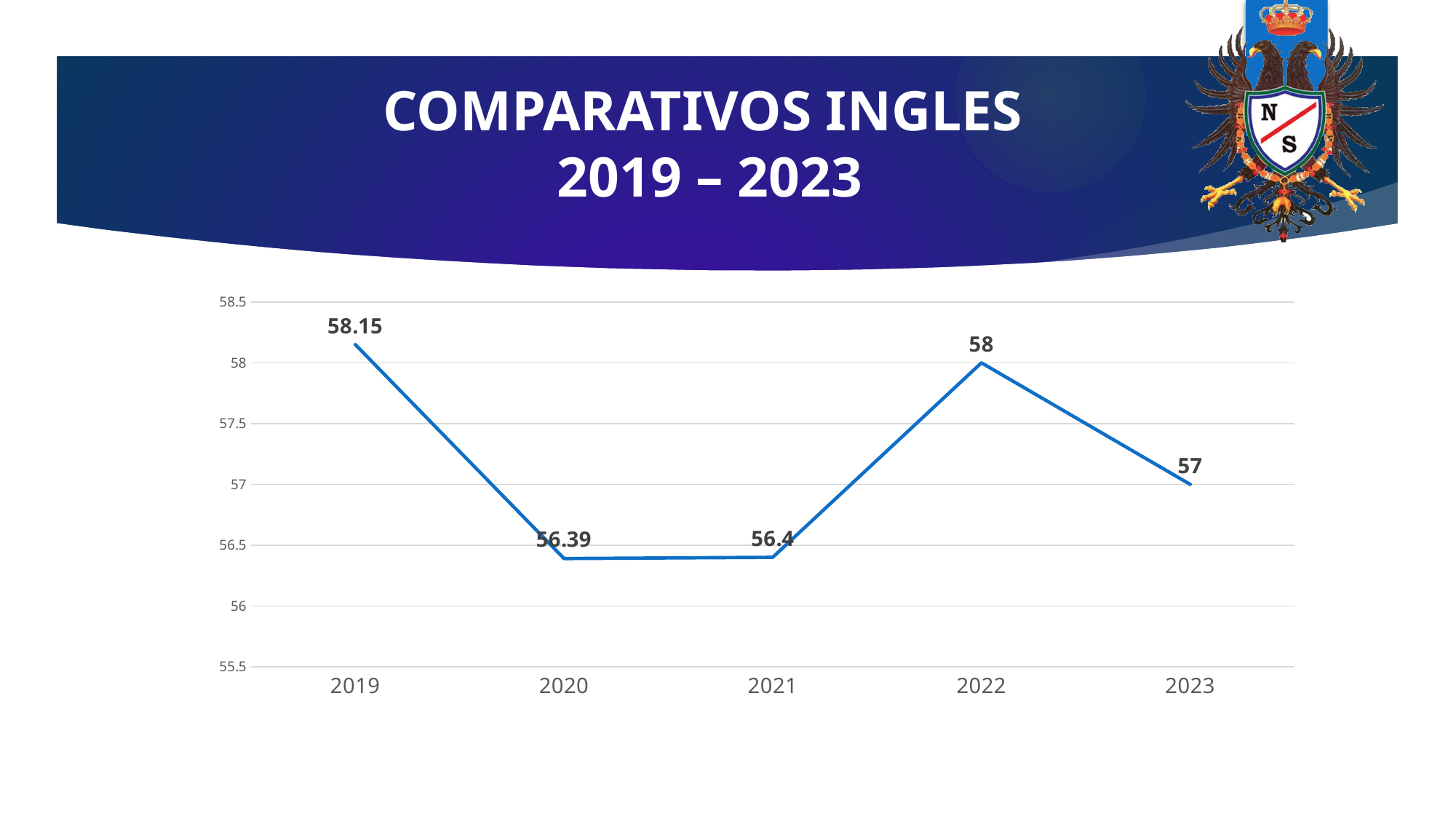
What is the value for 2019? 58.15 What is the value for 2021? 56.4 What kind of chart is shown on the slide? line chart Is the value for 2020 greater or less than 57? less What is the difference between the values for 2022 and 2023? 1 What is the value for 2023? 57 Which year has the lowest value? 2020 How many years are plotted on the chart? 5 Which year has the highest value? 2019 Which is larger, the value for 2022 or the value for 2023? 2022 What is the difference between the values for 2019 and 2022? 0.15 Does the value rise or fall from 2022 to 2023? fall